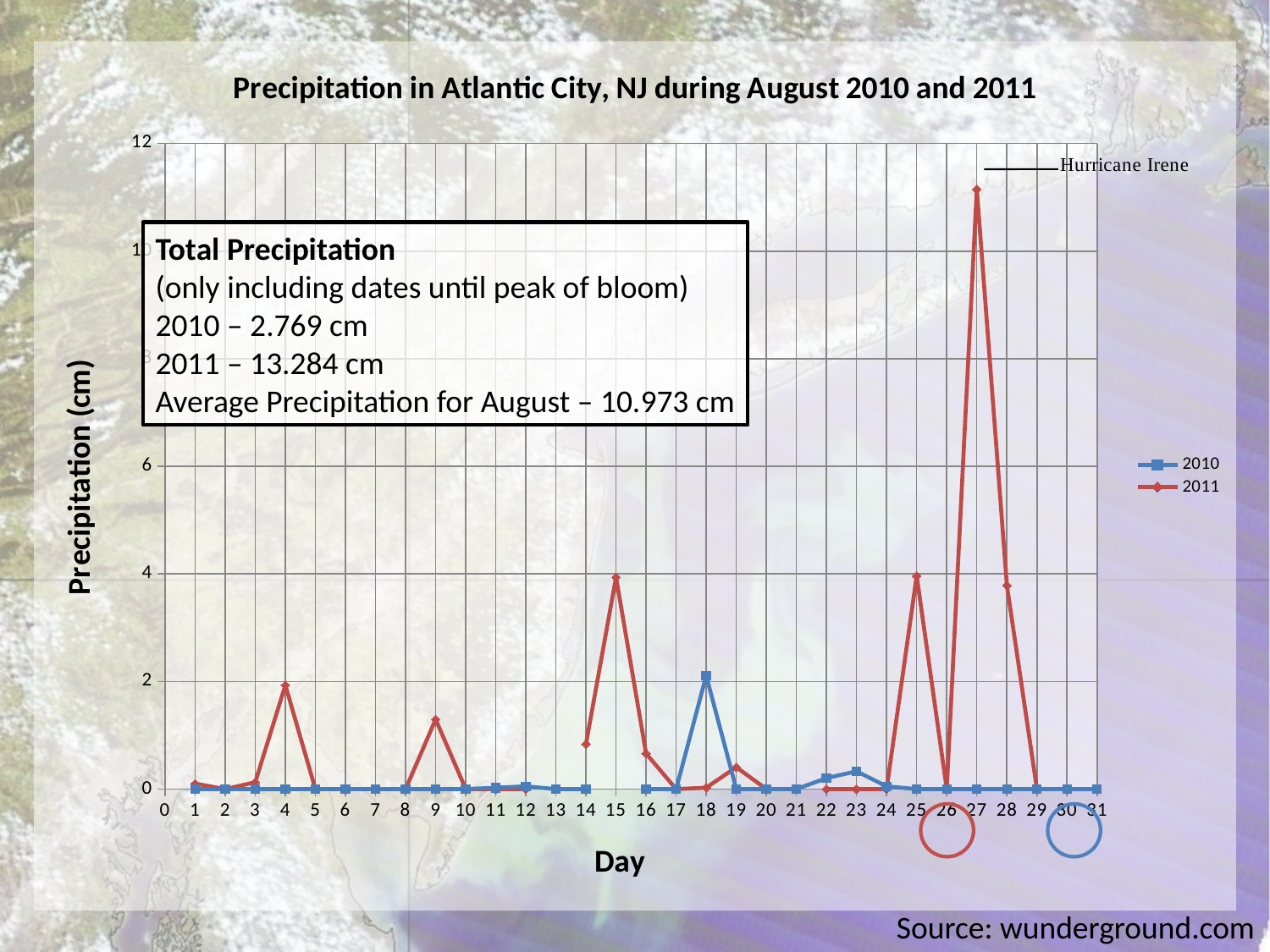
On day 25, which series has the larger value, 2010 or 2011? 2011 What kind of chart is shown on the slide? Line chart What is the title of the chart? Precipitation in Atlantic City, NJ during August 2010 and 2011 Which series does the legend list in addition to 2010? 2011 Is the value for 2010 on day 18 greater or less than 1? greater Is the value for 2011 on day 15 greater or less than 2? greater On which day does the 2010 series reach its highest value? 18 On which day does the 2011 series reach its highest value? 27 On day 18, which series has the larger value, 2010 or 2011? 2010 Is the value for 2011 on day 27 greater or less than 10? greater How many series does the legend list? 2